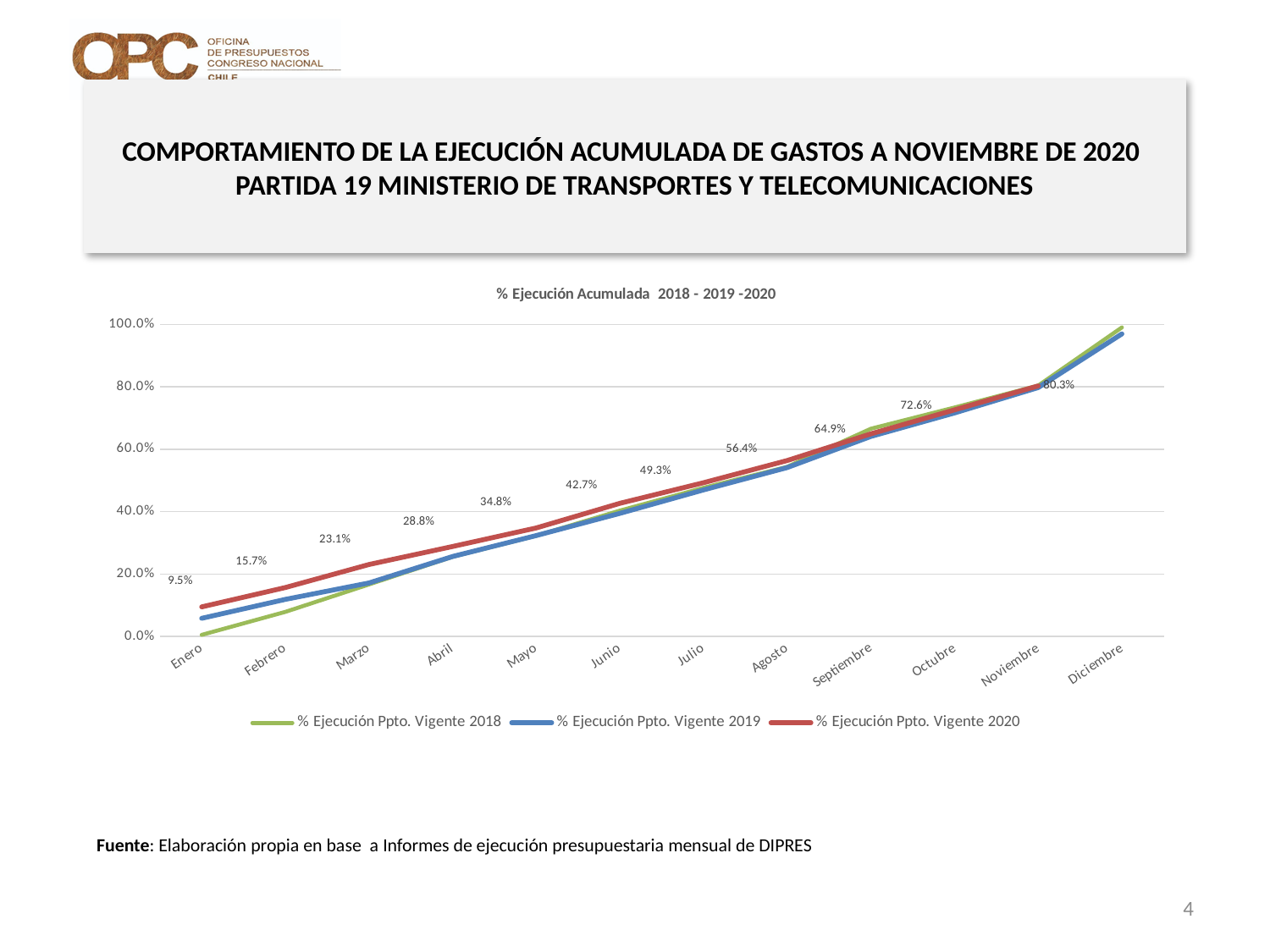
What is the difference between the % Ejecución Ppto. Vigente 2020 values for Octubre and Septiembre? 7.7% What is the title of the chart? % Ejecución Acumulada 2018 - 2019 -2020 What is the value for % Ejecución Ppto. Vigente 2020 in Junio? 42.7% Is the value for % Ejecución Ppto. Vigente 2018 in Diciembre greater or less than 80.0%? greater What is the value for % Ejecución Ppto. Vigente 2020 in Enero? 9.5% How many series does the legend list? 3 What type of chart is shown on the slide? line chart Do the values for % Ejecución Ppto. Vigente 2020 rise or fall from Enero to Noviembre? rise Is the value for % Ejecución Ppto. Vigente 2019 in Enero greater or less than 20.0%? less What is the value for % Ejecución Ppto. Vigente 2020 in Septiembre? 64.9% What is the value for % Ejecución Ppto. Vigente 2020 in Noviembre? 80.3% What is the difference between the % Ejecución Ppto. Vigente 2020 values for Noviembre and Enero? 70.8%